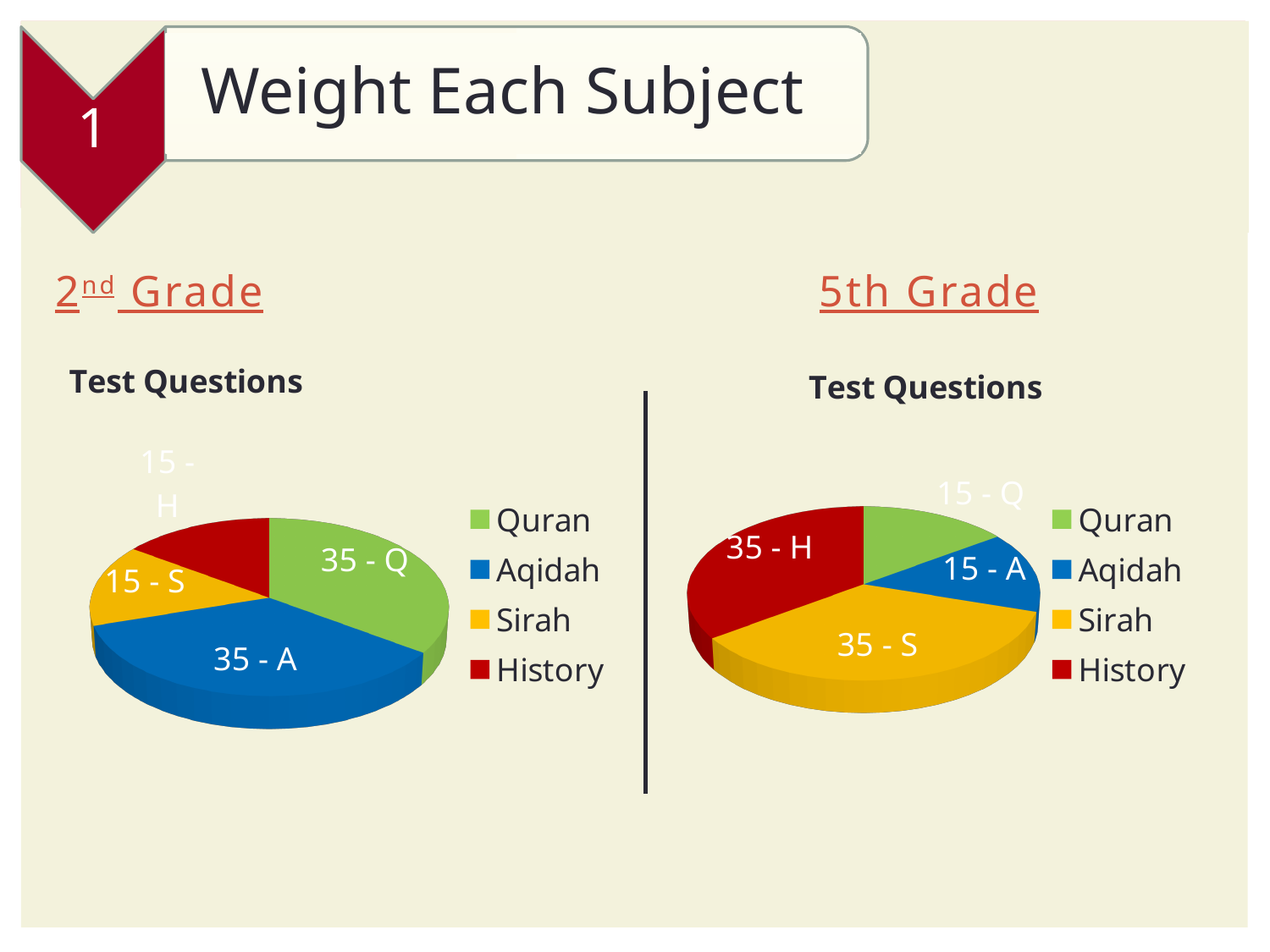
On the 2nd Grade Test Questions chart, what is the value for Quran? 35 On the 5th Grade Test Questions chart, what share of the total does Sirah represent? 35% On the 5th Grade Test Questions chart, what is the difference between the values for Sirah and Aqidah? 20 On the 5th Grade Test Questions chart, what is the value for History? 35 On the 5th Grade Test Questions chart, which is larger, Quran or Sirah? Sirah On the 2nd Grade Test Questions chart, which is larger, Aqidah or History? Aqidah On the 2nd Grade Test Questions chart, what is the difference between the values for Quran and History? 20 On the 2nd Grade Test Questions chart, which colour represents Sirah? Yellow How many slices does the 2nd Grade Test Questions chart have? 4 On the 2nd Grade Test Questions chart, what is the value for Sirah? 15 What kind of chart is the 5th Grade Test Questions chart? Pie chart On the 5th Grade Test Questions chart, what is the value for Aqidah? 15